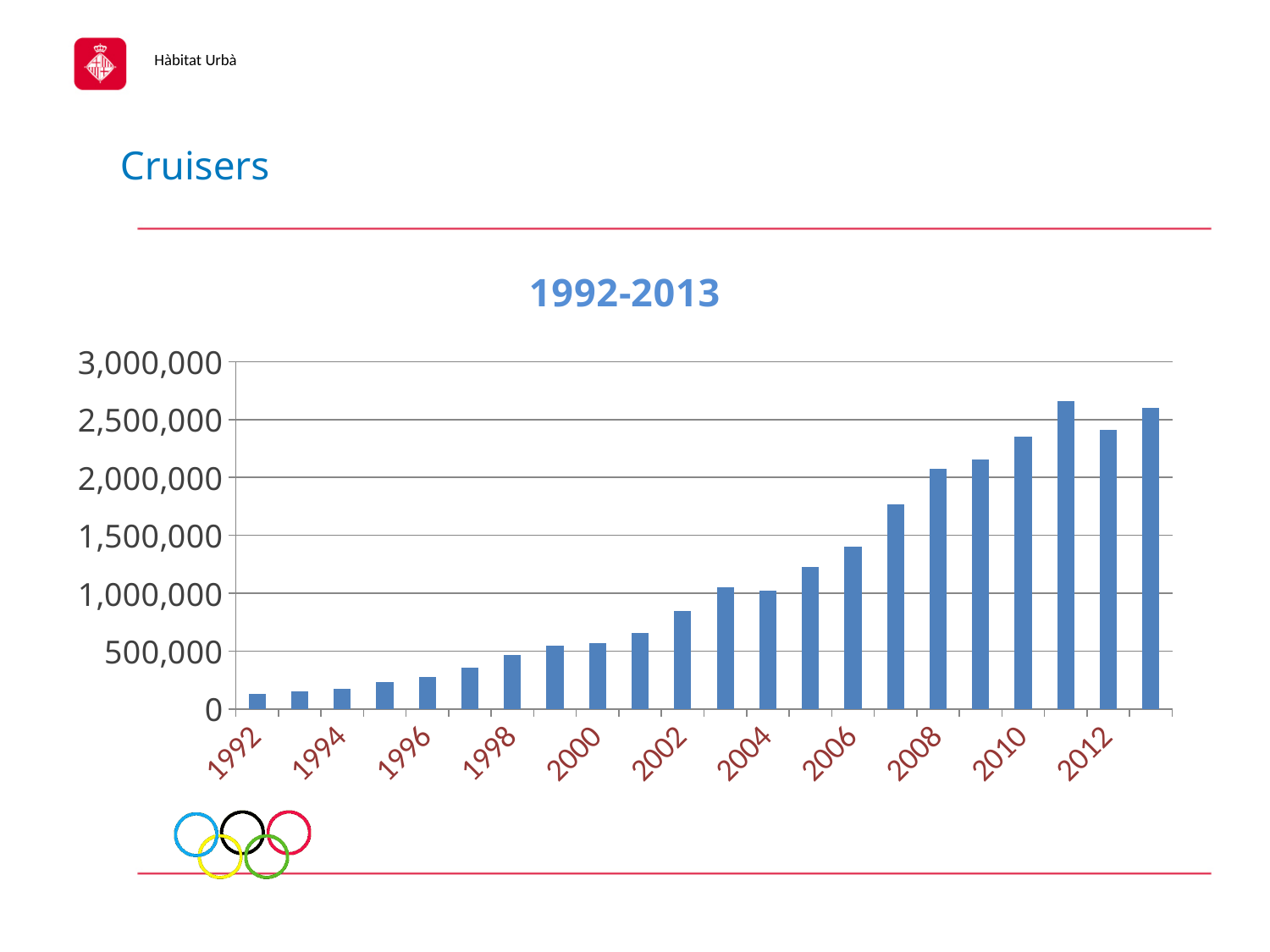
Which year has the larger value, 2008 or 2012? 2012 Do the values generally rise or fall from 1992 to 2013? rise Is the value for 2006 greater or less than 1,500,000? less Is the value for 2002 greater or less than 1,000,000? less Which year has the larger value, 2000 or 2006? 2006 Is the value for 1992 greater or less than 500,000? less What is the title of the chart? 1992-2013 How many bars (years) are plotted in the chart? 22 Which year has the lowest value in the chart? 1992 What kind of chart is shown on the slide? bar chart